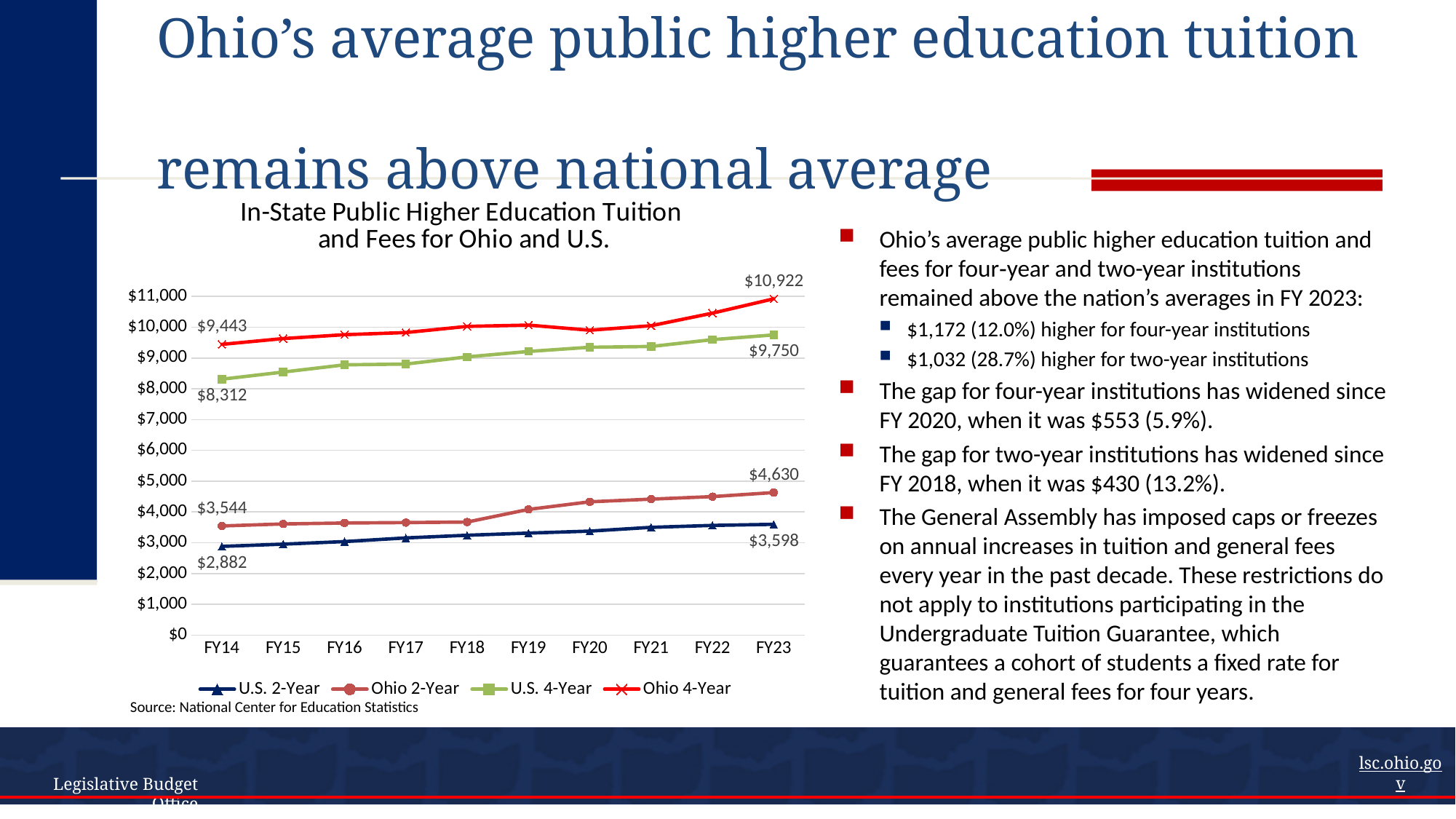
What is the difference between the Ohio 4-Year and U.S. 4-Year values in FY23? $1,172 What is the U.S. 4-Year value for FY14? $8,312 How many fiscal years are plotted on the x axis? 10 What type of chart is shown on the slide? Line chart What is the U.S. 2-Year tuition and fees value for FY14? $2,882 How many series does the legend list? 4 Is the Ohio 2-Year value for FY20 greater or less than $4,000? greater What is the Ohio 2-Year value for FY23? $4,630 Does the U.S. 2-Year series rise or fall from FY14 to FY23? Rise Which series has the highest value in FY23? Ohio 4-Year Which series has the lowest value in FY14? U.S. 2-Year What is the Ohio 4-Year tuition and fees value for FY23? $10,922